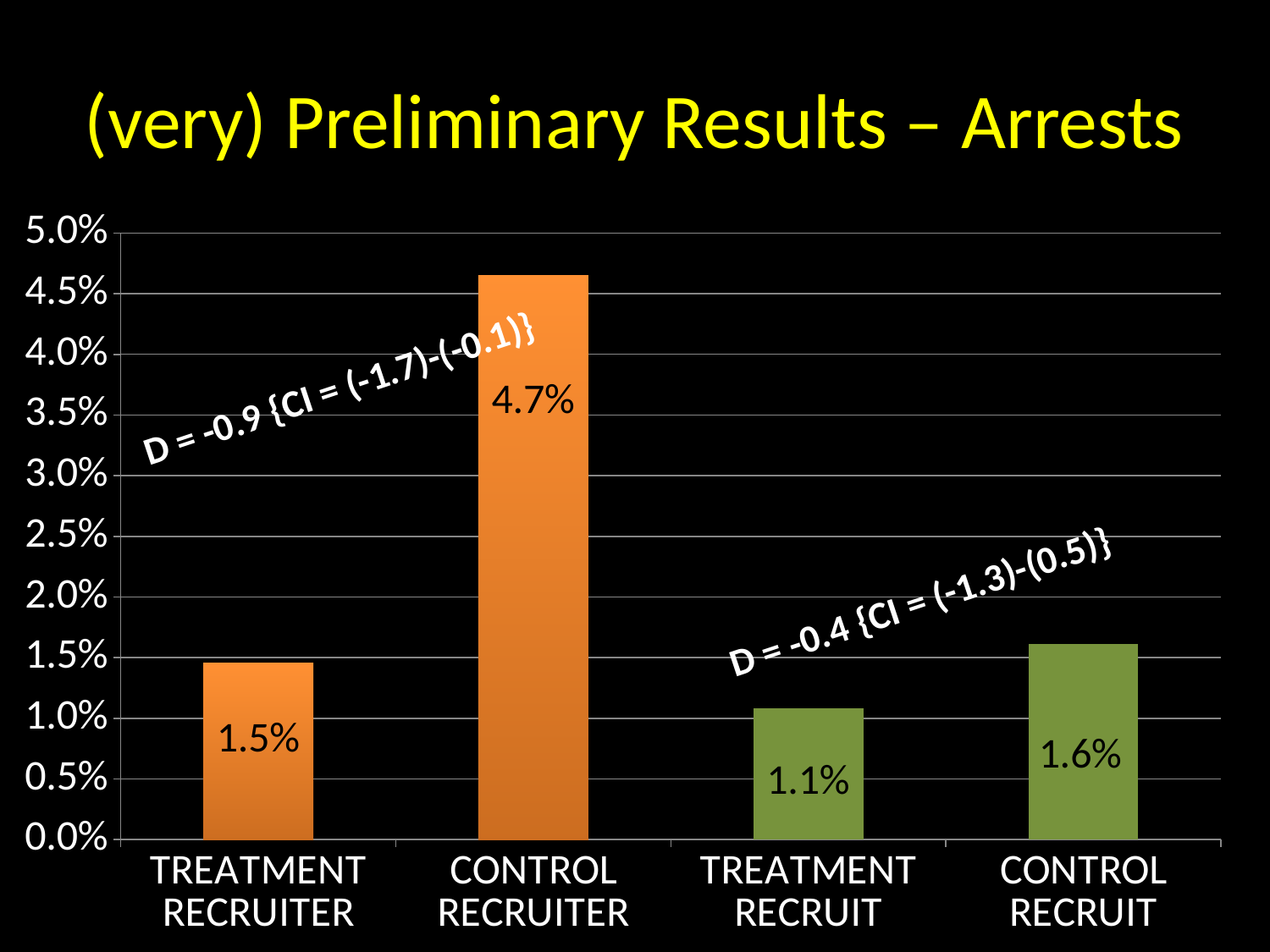
Which category has the highest value? CONTROL RECRUITER Which category has the lowest value? TREATMENT RECRUIT What is the value for TREATMENT RECRUITER? 1.5% Is the value for CONTROL RECRUITER greater or less than 4.0%? greater What is the difference between the values for CONTROL RECRUITER and TREATMENT RECRUITER? 3.2% How many categories are shown on the x axis? 4 What kind of chart is shown on the slide? bar chart What is the title of the slide? (very) Preliminary Results – Arrests What is the value for TREATMENT RECRUIT? 1.1% What is the value for CONTROL RECRUITER? 4.7% What is the value for CONTROL RECRUIT? 1.6% Which is larger, the value for CONTROL RECRUITER or the value for CONTROL RECRUIT? CONTROL RECRUITER